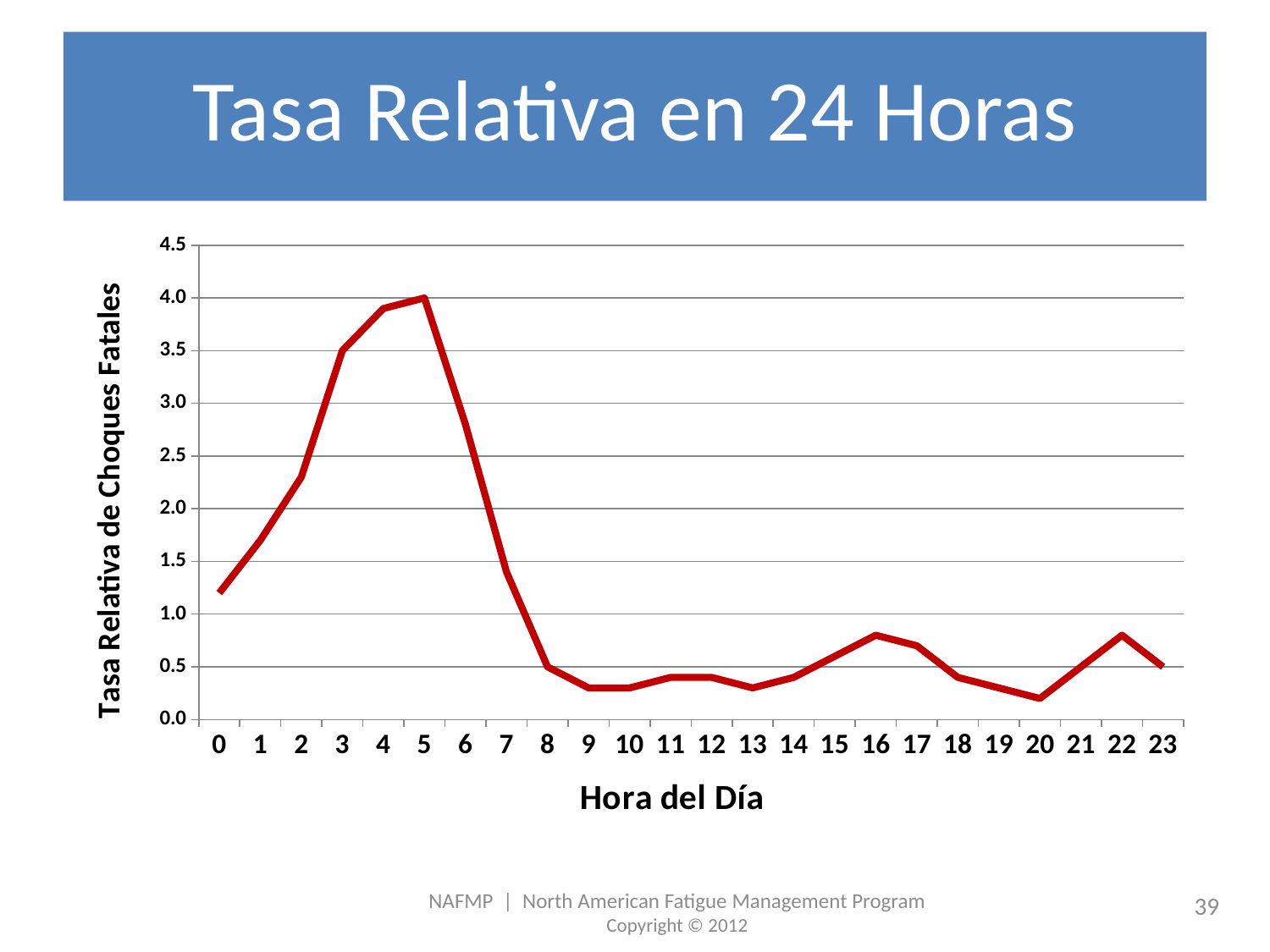
Which hour has a higher relative rate, hour 2 or hour 16? 2 At which hour of the day is the relative rate of fatal crashes lowest? 20 At which hour of the day is the relative rate of fatal crashes highest? 5 Does the relative rate rise or fall between hour 5 and hour 8? fall What is the label of the x axis? Hora del Día Is the value at hour 0 greater or less than 1.0? greater What is the title of the slide's chart? Tasa Relativa en 24 Horas Is the value at hour 9 greater or less than 0.5? less Is the value at hour 3 greater or less than 3.0? greater How many hours (points) are plotted along the x axis? 24 What kind of chart is shown on the slide? line chart What is the relative rate of fatal crashes at hour 5? 4.0